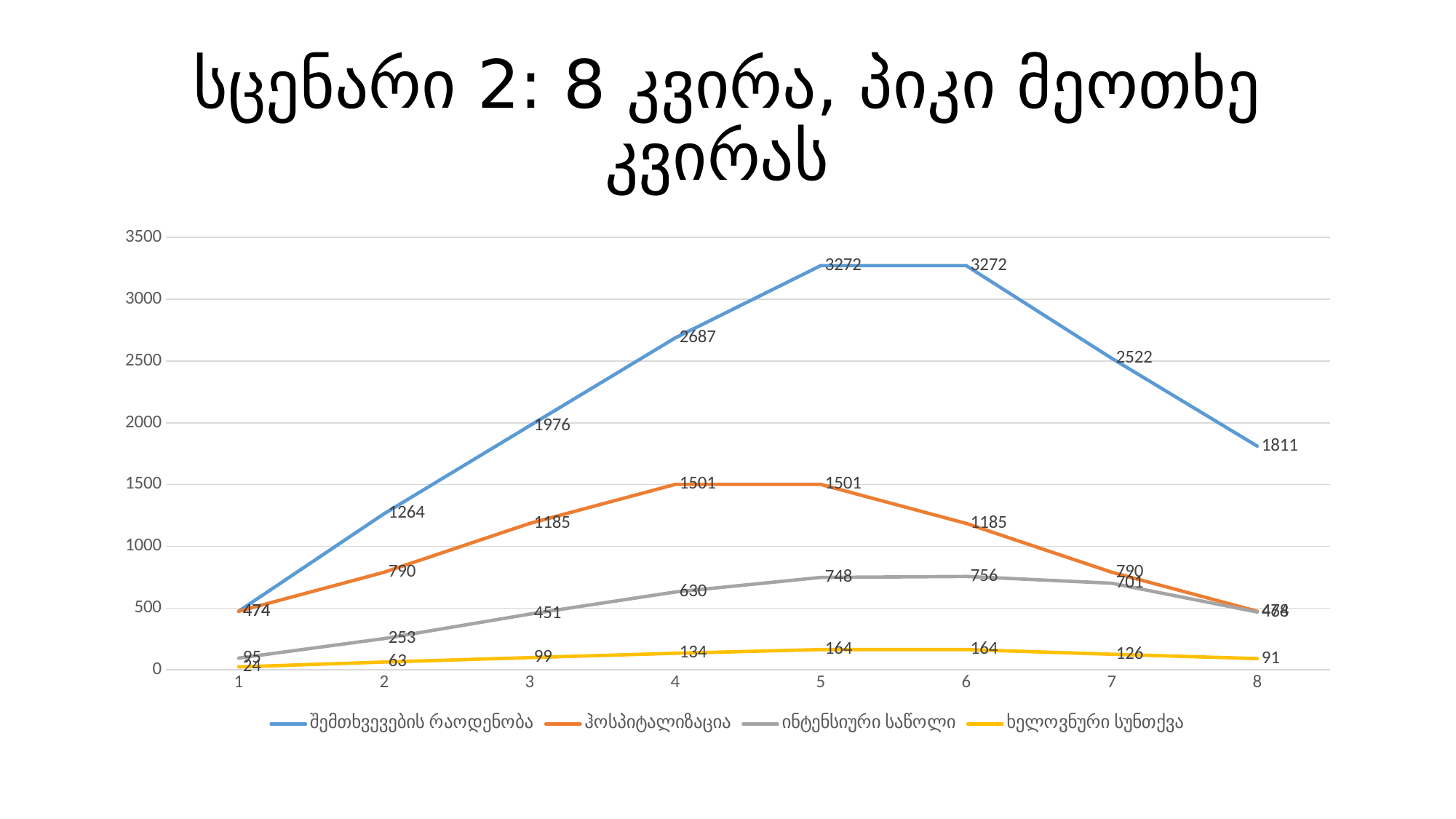
What is the value of the ხელოვნური სუნთქვა series at week 7? 126 What type of chart is shown on the slide? line chart At which week does the ხელოვნური სუნთქვა series reach its lowest value? 1 What is the highest value reached by the შემთხვევების რაოდენობა series? 3272 What is the value of the ინტენსიური საწოლი series at week 6? 756 What is the value of the ჰოსპიტალიზაცია series at week 3? 1185 Which is larger at week 5: the ჰოსპიტალიზაცია value or the ინტენსიური საწოლი value? ჰოსპიტალიზაცია How many points (weeks) are plotted along the x axis? 8 Does the შემთხვევების რაოდენობა series rise or fall from week 6 to week 8? fall How many series does the legend list? 4 What is the value of the შემთხვევების რაოდენობა series at week 4? 2687 What is the difference between the შემთხვევების რაოდენობა values at week 6 and week 7? 750